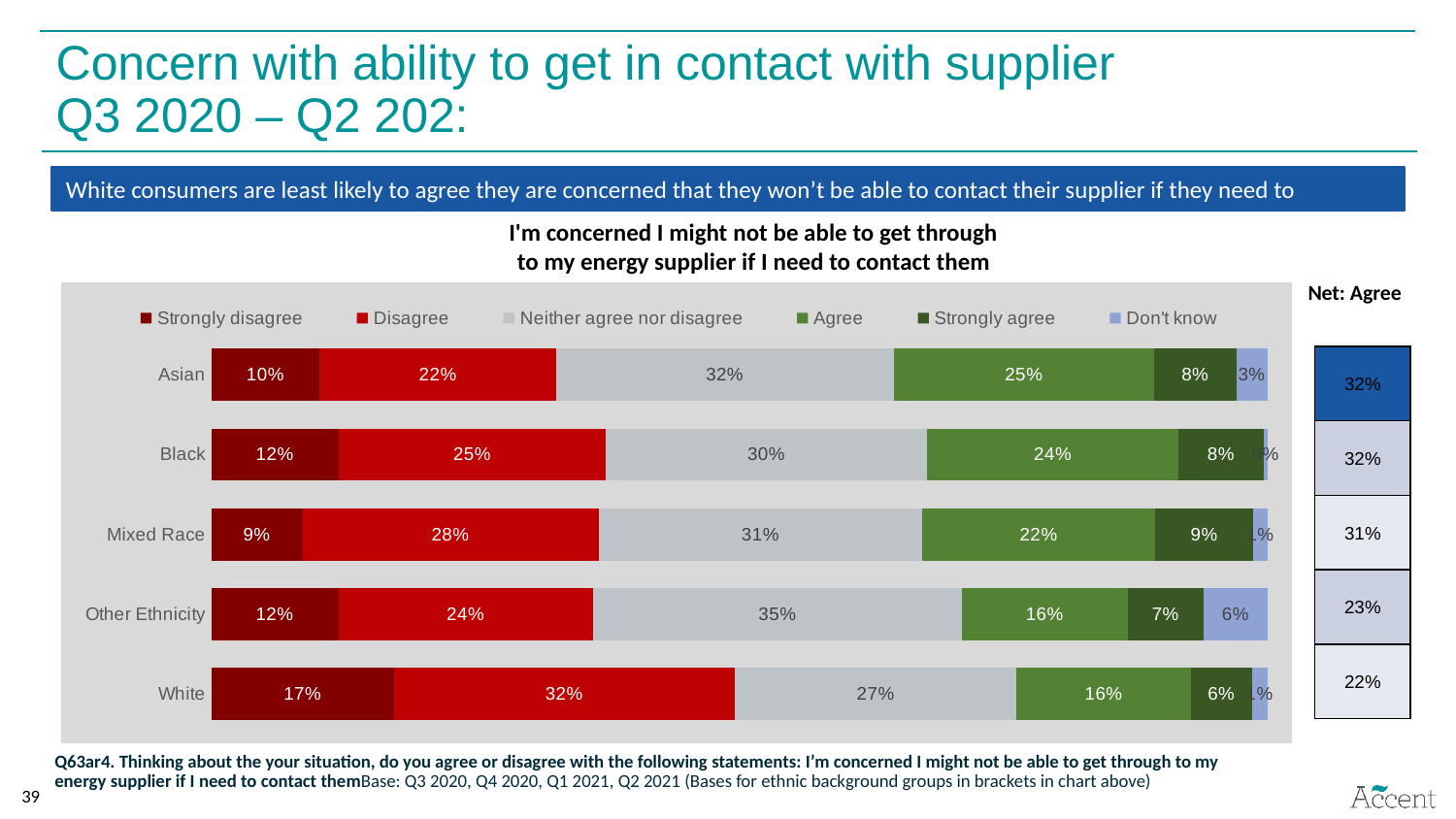
What is the 'Neither agree nor disagree' value for Other Ethnicity? 35% How many series does the chart legend list? 6 What percentage of White consumers strongly disagree with the statement? 17% What is the Net: Agree figure for Mixed Race? 31% Which has a larger 'Strongly disagree' value, Black or Mixed Race? Black What is the combined 'Strongly disagree' and 'Disagree' percentage for White? 49% What kind of chart is shown on the slide? Stacked bar chart What is the difference between the 'Agree' value for Asian and the 'Agree' value for White? 9 percentage points Which ethnic group has the highest 'Disagree' percentage? White Which ethnic group has the lowest 'Strongly agree' percentage? White What is the 'Don't know' value for Other Ethnicity? 6% How many ethnic groups are plotted in the chart? 5